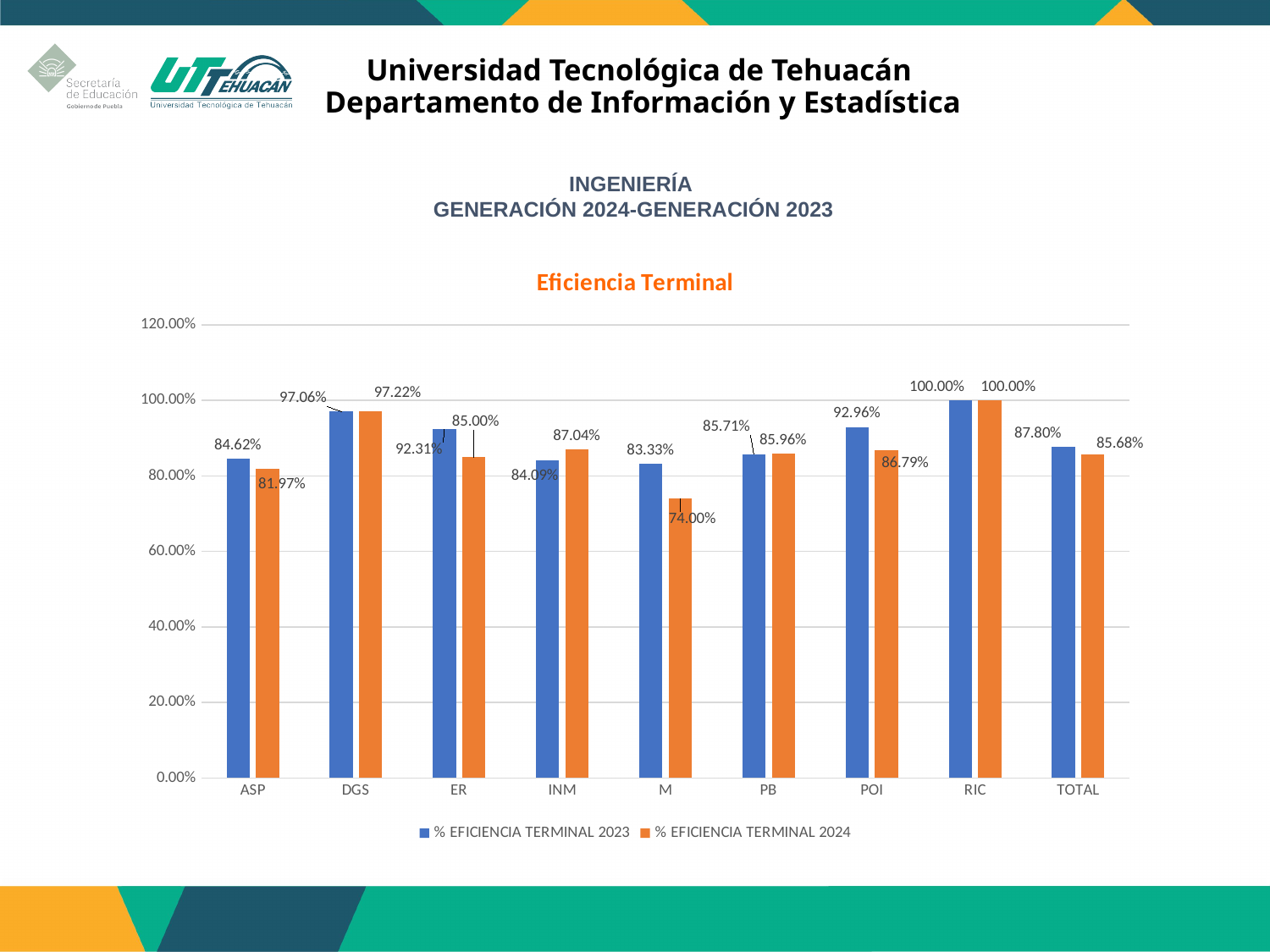
Which category has the lowest % EFICIENCIA TERMINAL 2024 value? M What kind of chart is shown? bar chart What is the title of the chart? Eficiencia Terminal For POI, which is larger: the 2023 value or the 2024 value? 2023 What is the difference between the 2023 and 2024 values for ER? 7.31 percentage points How many categories are shown on the x axis? 9 Which category has the highest % EFICIENCIA TERMINAL 2024 value? RIC What is the % EFICIENCIA TERMINAL 2024 value for M? 74.00% Is the % EFICIENCIA TERMINAL 2024 value for M greater or less than 80.00%? less How many series does the legend list? 2 What is the % EFICIENCIA TERMINAL 2023 value for ASP? 84.62% What is the % EFICIENCIA TERMINAL 2024 value for TOTAL? 85.68%